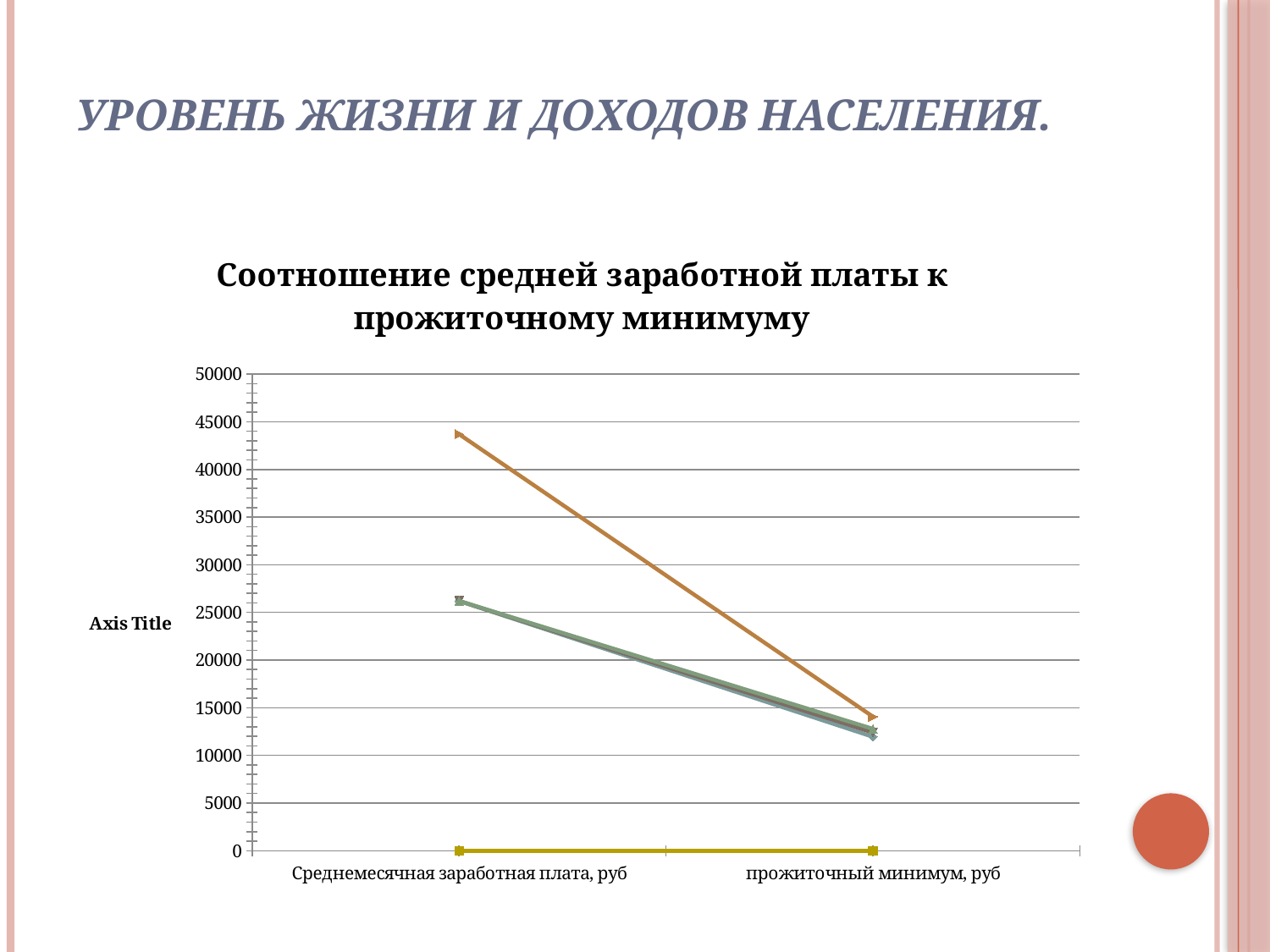
Is the value of the orange line for прожиточный минимум, руб greater or less than 15000? less Is the value of the green line for Среднемесячная заработная плата, руб greater or less than 25000? greater How many categories are shown on the x axis of the chart? 2 Is the value of the green line for прожиточный минимум, руб greater or less than 15000? less Do the values of the orange line rise or fall from the first category to the second? fall What kind of chart is shown on the slide? line chart Which line has the higher value for Среднемесячная заработная плата, руб: the orange line or the green line? the orange line For the orange line, which category has the lowest value? прожиточный минимум, руб What is the highest value shown on the vertical axis of the chart? 50000 What is the label of the first category on the x axis? Среднемесячная заработная плата, руб What is the title of the chart? Соотношение средней заработной платы к прожиточному минимуму